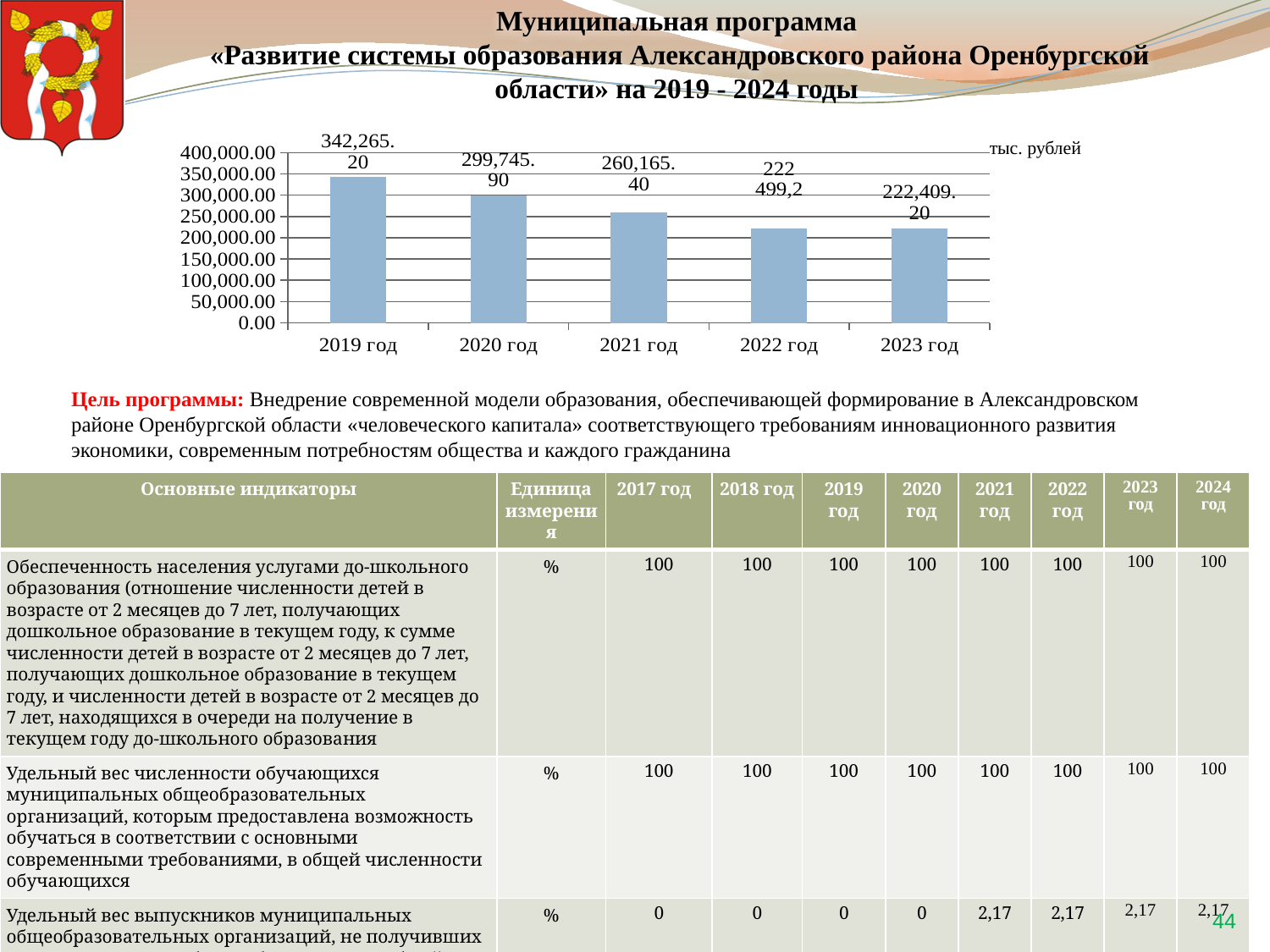
What is the value shown for 2019 год in the bar chart? 342,265.20 What is the value shown for 2021 год in the bar chart? 260,165.40 What is the value shown for 2023 год in the bar chart? 222,409.20 What unit of measurement is indicated next to the bar chart? тыс. рублей How many years (categories) are plotted in the bar chart? 5 Do the values in the bar chart rise or fall from 2019 год to 2023 год? fall Which is larger, the value for 2020 год or the value for 2021 год? 2020 год Which year has the highest value in the bar chart? 2019 год What type of chart is shown on the slide? bar chart Is the value for 2022 год greater or less than 250,000.00? less What is the value shown for 2020 год in the bar chart? 299,745.90 What is the difference between the values for 2019 год and 2020 год? 42,519.30